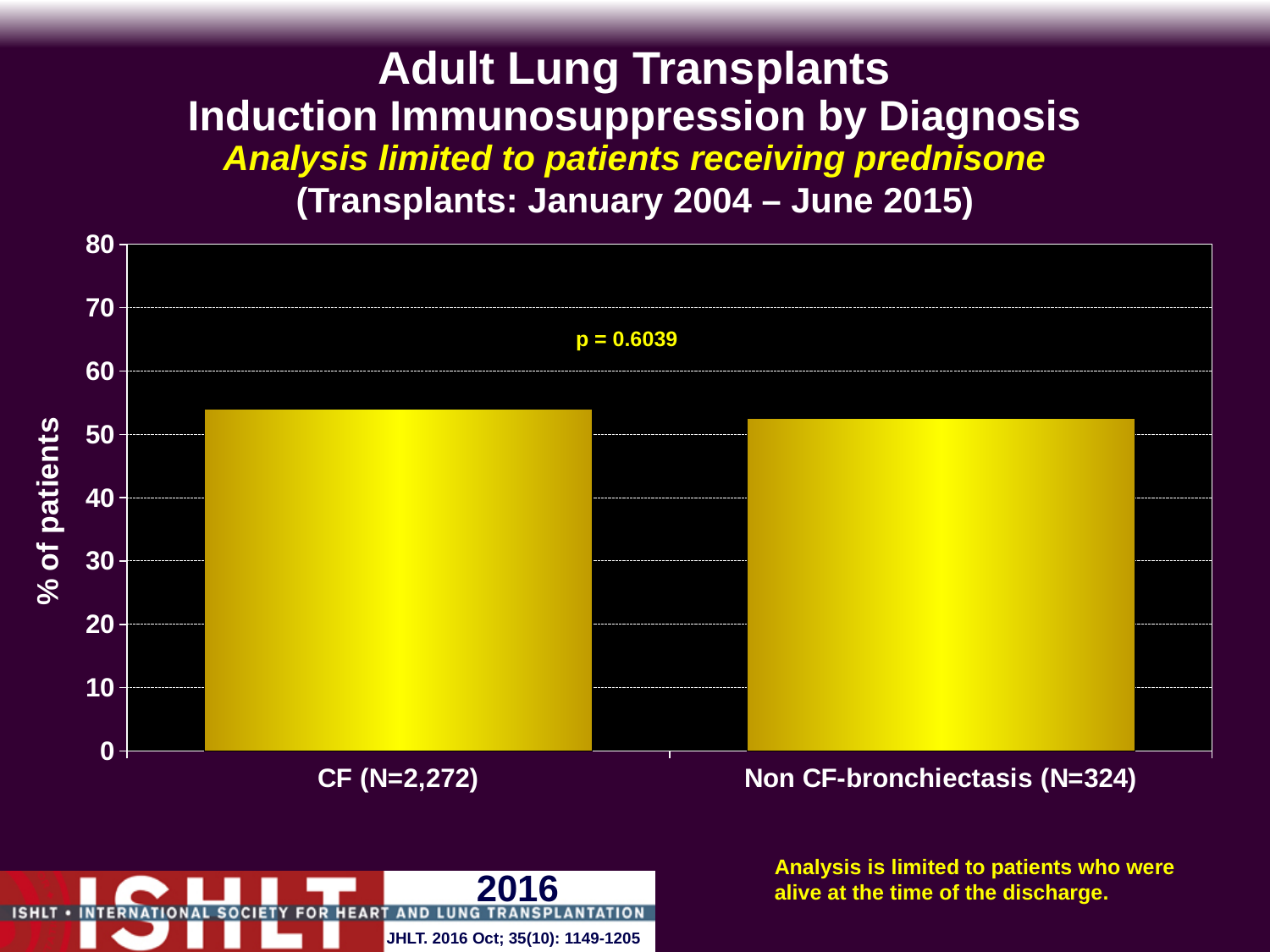
Is the value for Non CF-bronchiectasis (N=324) greater or less than 40? greater What is the sample size (N) given for the Non CF-bronchiectasis category? 324 What is the maximum value shown on the y-axis? 80 How many diagnosis categories are plotted on the chart? 2 Is the value for CF (N=2,272) greater or less than 50? greater What is the label of the y-axis? % of patients Is the value for Non CF-bronchiectasis (N=324) greater or less than 60? less What is the sample size (N) given for the CF category? 2,272 What kind of chart is shown on the slide? bar chart What p-value is printed on the chart? p = 0.6039